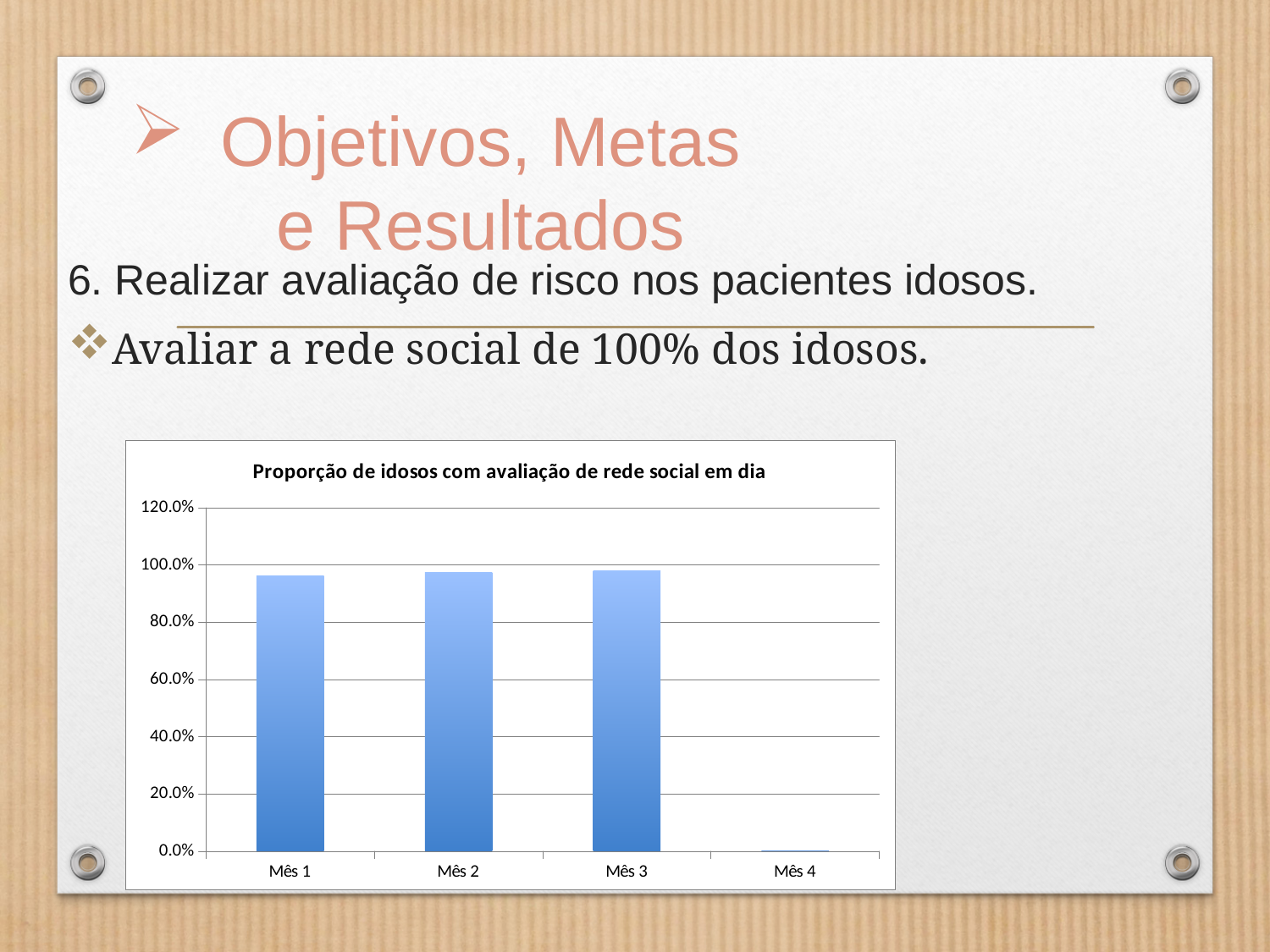
Is the value for Mês 3 greater or less than 40.0%? greater What is the title of the chart? Proporção de idosos com avaliação de rede social em dia What kind of chart is shown on the slide? bar chart How many months (categories) are shown on the x axis of the chart? 4 Which month has the lowest value in the chart? Mês 4 Is the value for Mês 4 greater or less than 20.0%? less Which is larger, the value for Mês 1 or the value for Mês 4? Mês 1 What is the highest tick value shown on the y axis of the chart? 120.0% Is the value for Mês 1 greater or less than 80.0%? greater Does the value rise or fall from Mês 3 to Mês 4? fall Which is larger, the value for Mês 3 or the value for Mês 4? Mês 3